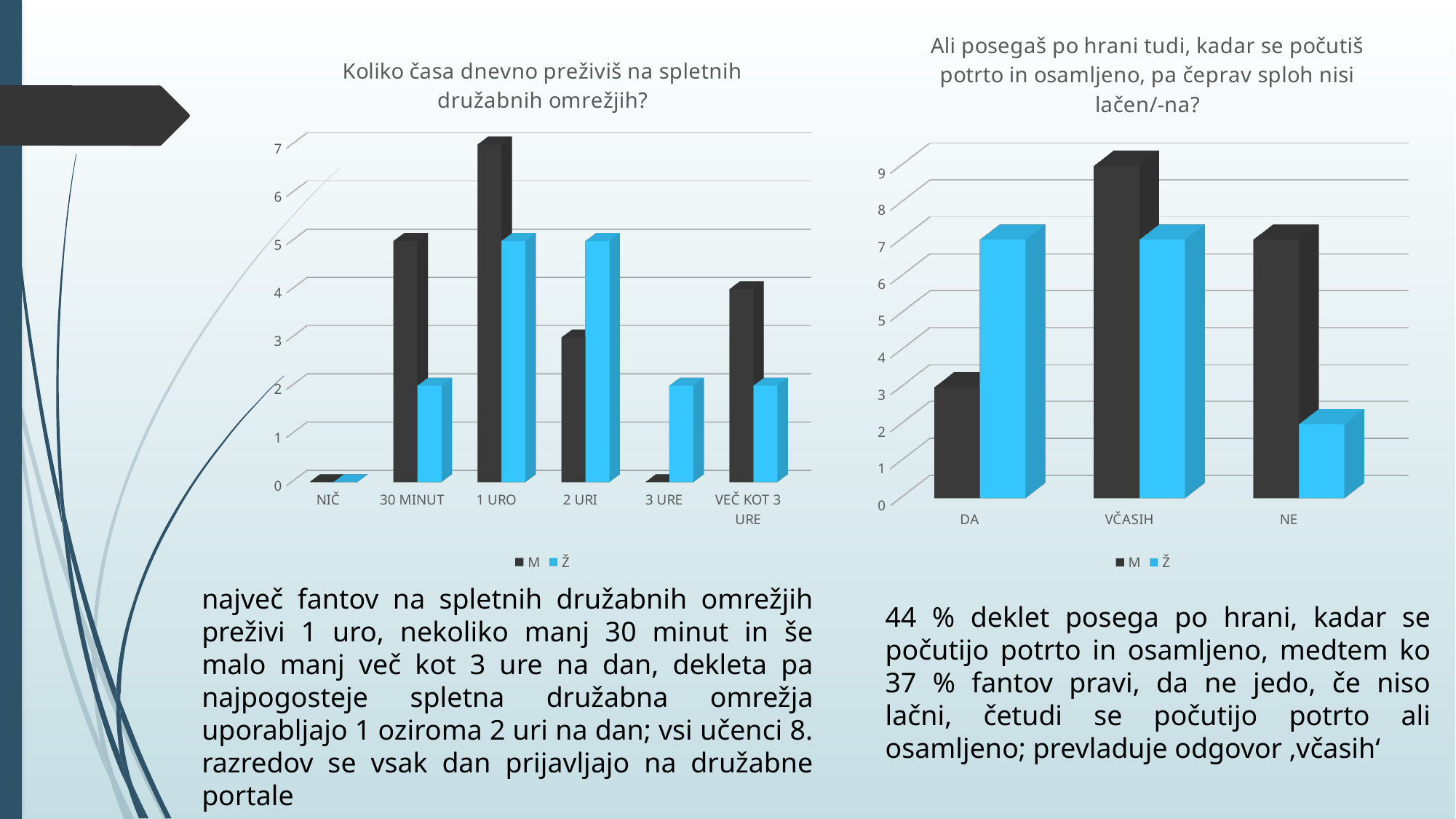
What kind of chart is the left chart titled "Koliko časa dnevno preživiš na spletnih družabnih omrežjih?"? bar chart How many categories are shown on the x axis of the right chart about eating when feeling down and lonely? 3 In the left chart about time spent on social networks, which is larger at 2 URI, M or Ž? Ž In the right chart about eating when feeling down and lonely, is the value for Ž at NE greater or less than 4? less What kind of chart is the right chart about eating when feeling down and lonely? bar chart In the right chart about eating when feeling down and lonely, which is larger at DA, M or Ž? Ž In the left chart about time spent on social networks, is the value for Ž at 3 URE greater or less than 3? less In the left chart about time spent on social networks, which category has the highest value for M? 1 URO How many categories are shown on the x axis of the left chart about time spent on social networks? 6 In the right chart about eating when feeling down and lonely, which category has the highest value for M? VČASIH How many series does the legend of the left chart list? 2 In the left chart about time spent on social networks, is the value for M at 30 MINUT greater or less than 4? greater